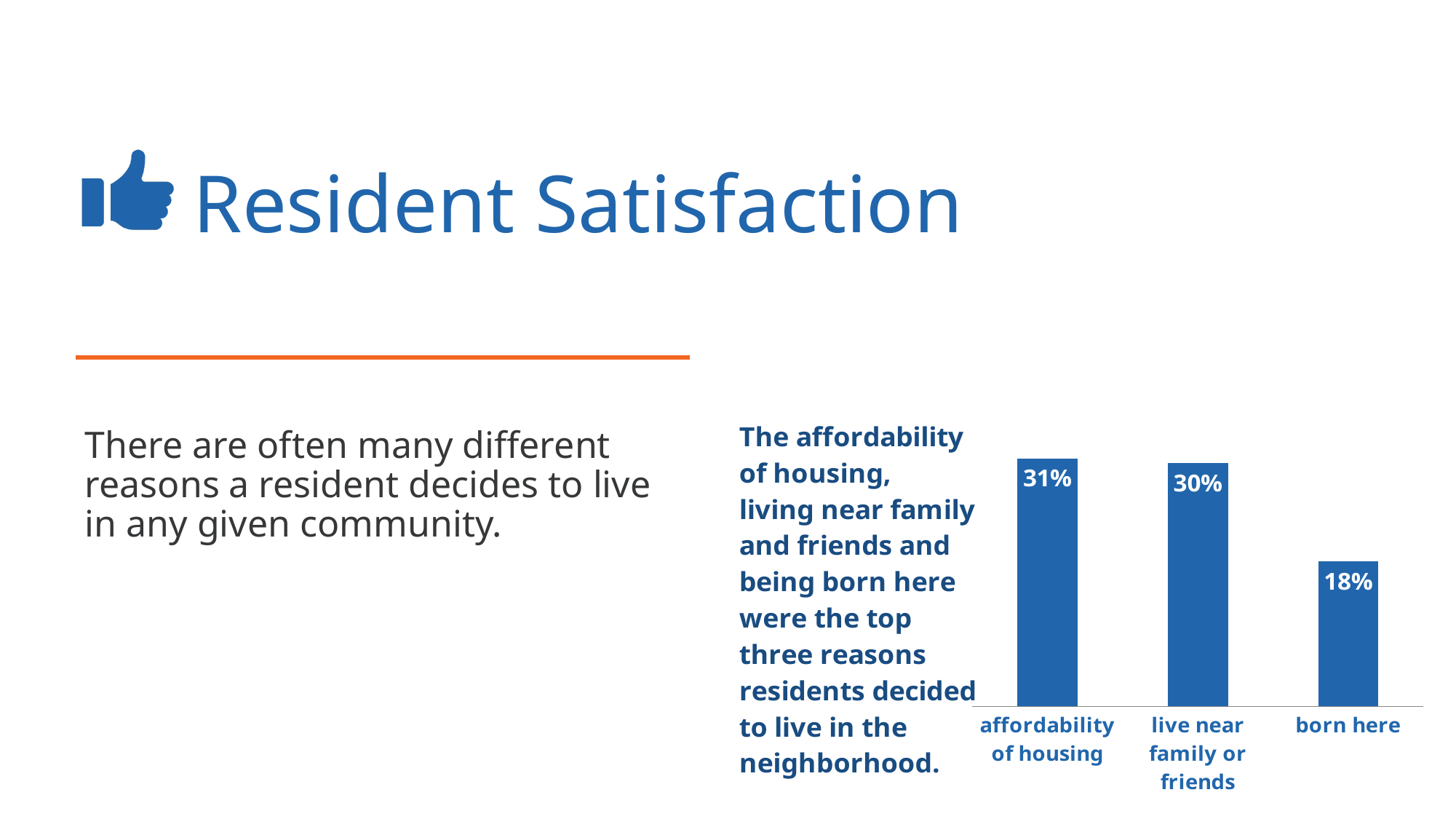
Which category has the lowest value? born here What kind of chart is shown on the slide? bar chart What is the difference between the values for live near family or friends and born here? 12% Do the values rise or fall from left to right across the categories? fall What is the difference between the values for affordability of housing and born here? 13% What is the value for born here? 18% Which is larger, the value for live near family or friends or the value for born here? live near family or friends What colour are the bars in the chart? blue What is the value for affordability of housing? 31% How many categories are shown in the chart? 3 What is the value for live near family or friends? 30%